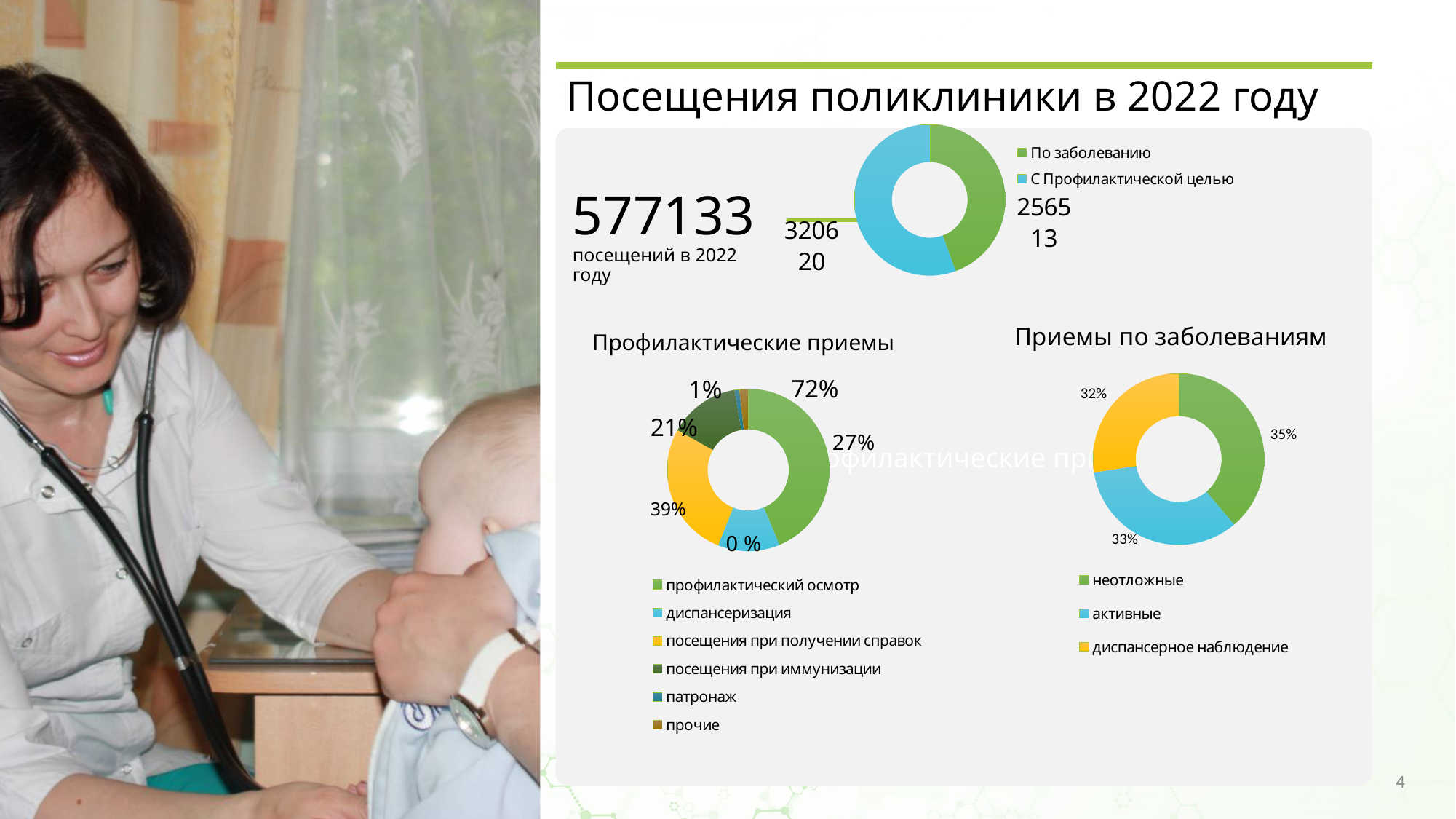
In the top donut chart next to the number 577133, which category has the larger share: 'По заболеванию' or 'С Профилактической целью'? С Профилактической целью In the chart 'Приемы по заболеваниям', what is the difference in percentage points between 'неотложные' and 'активные'? 2 In the chart 'Профилактические приемы', which colour represents 'диспансеризация' in the legend? Light blue In the chart 'Приемы по заболеваниям', which category has the smallest share? диспансерное наблюдение In the chart 'Приемы по заболеваниям', what is the share for 'диспансерное наблюдение'? 32% How many categories does the legend of the chart 'Профилактические приемы' list? 6 In the chart 'Приемы по заболеваниям', what is the share for 'активные'? 33% In the chart 'Приемы по заболеваниям', what is the share for 'неотложные'? 35% What kind of chart is 'Приемы по заболеваниям'? Donut (pie) chart How many categories does the legend of the top donut chart (next to 577133) list? 2 How many categories does the legend of the chart 'Приемы по заболеваниям' list? 3 In the chart 'Приемы по заболеваниям', which category has the largest share? неотложные